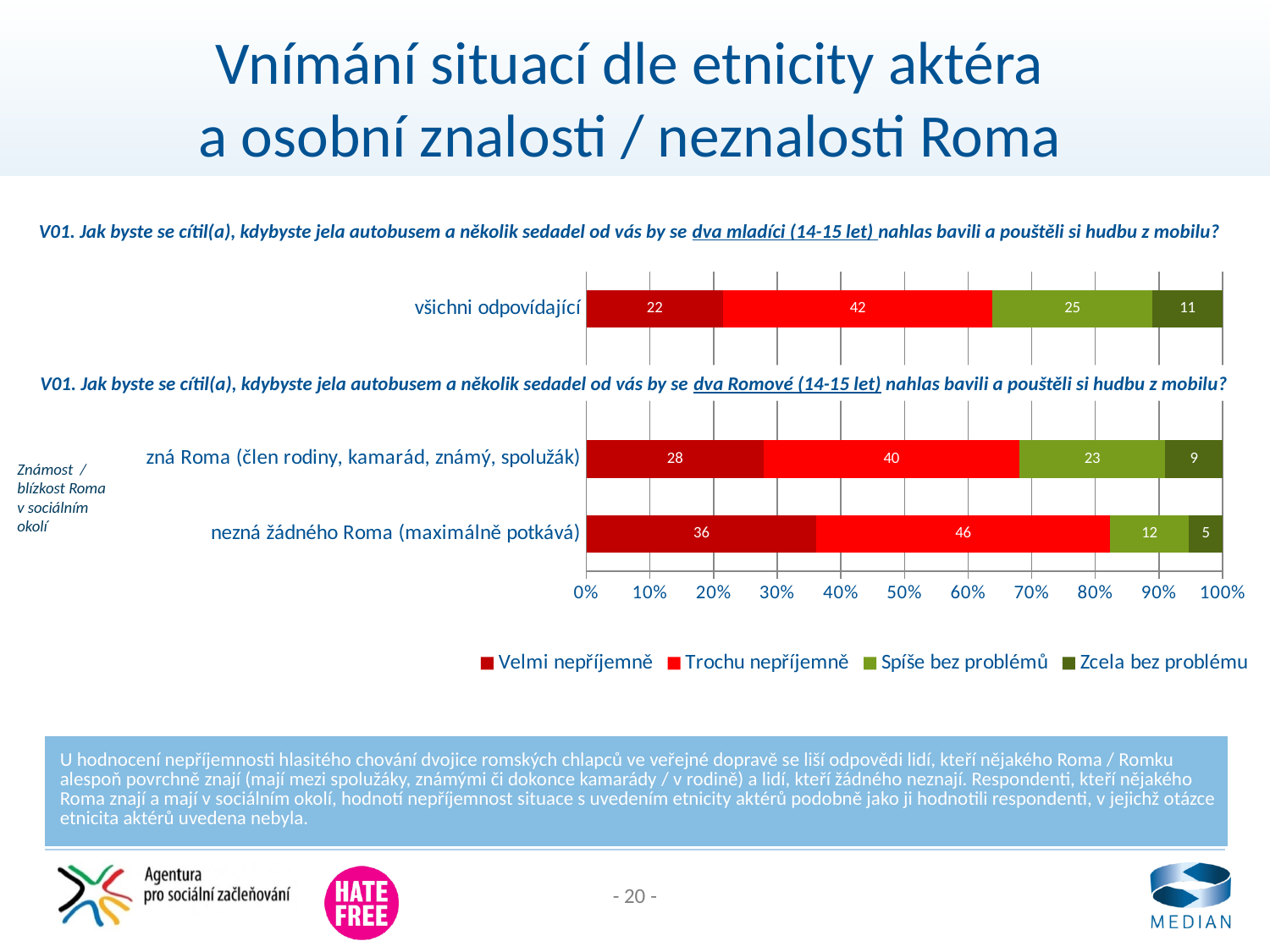
In the bottom chart (dva Romové), which segment is the smallest for 'nezná žádného Roma (maximálně potkává)'? Zcela bez problému In the bottom chart (dva Romové), what is the difference between the 'Trochu nepříjemně' values for 'nezná žádného Roma' and 'zná Roma'? 6 In the top chart (dva mladíci), what is the value for 'Trochu nepříjemně' for 'všichni odpovídající'? 42 In the top chart (dva mladíci), which segment is the largest for 'všichni odpovídající'? Trochu nepříjemně In the bottom chart (dva Romové), which category has the higher 'Velmi nepříjemně' value: 'zná Roma' or 'nezná žádného Roma'? nezná žádného Roma (maximálně potkává) In the bottom chart (dva Romové), what is the difference between the 'Spíše bez problémů' values for 'zná Roma' and 'nezná žádného Roma'? 11 How many series does the legend list? 4 In the bottom chart (dva Romové), what is the value for 'Velmi nepříjemně' for 'nezná žádného Roma (maximálně potkává)'? 36 In the bottom chart (dva Romové), what is the value for 'Spíše bez problémů' for 'zná Roma (člen rodiny, kamarád, známý, spolužák)'? 23 What kind of chart is used on this slide? Stacked horizontal bar chart In the top chart (dva mladíci), what is the value for 'Zcela bez problému' for 'všichni odpovídající'? 11 How many categories (bars) are shown in the bottom chart (dva Romové)? 2